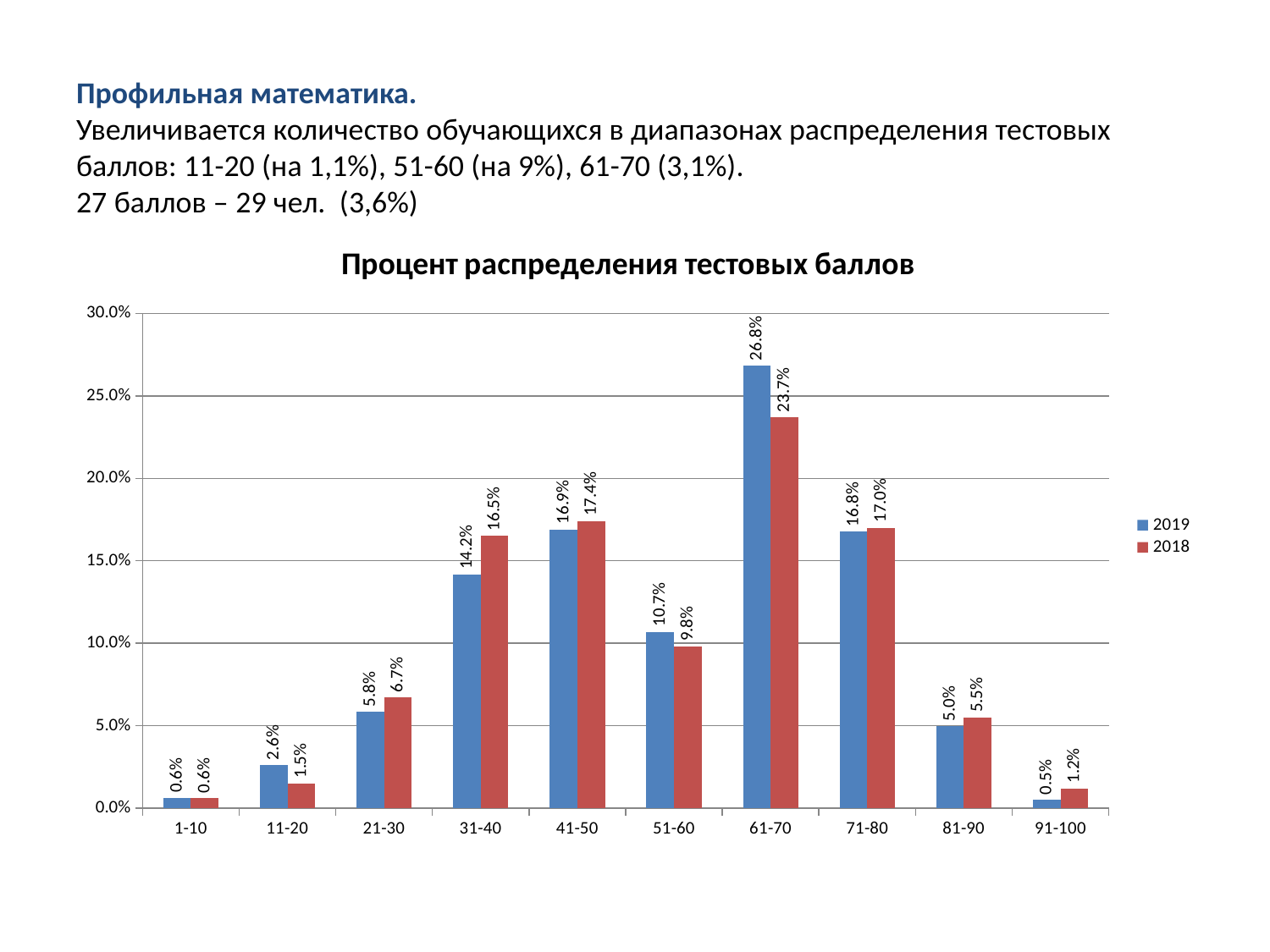
How many score ranges are shown on the x axis? 10 How many series does the legend list? 2 What is the difference between the 2019 and 2018 values for the 61-70 score range? 3.1% Is the 2018 value for the 71-80 score range greater or less than 15.0%? greater What is the title of the chart? Процент распределения тестовых баллов Which score range has the highest 2018 value? 61-70 Which is larger for the 21-30 score range, the 2019 value or the 2018 value? 2018 Which score range has the lowest 2019 value? 91-100 What is the 2018 value for the 31-40 score range? 16.5% What kind of chart is shown on the slide? bar chart What is the 2019 value for the 51-60 score range? 10.7% What is the 2019 value for the 61-70 score range? 26.8%